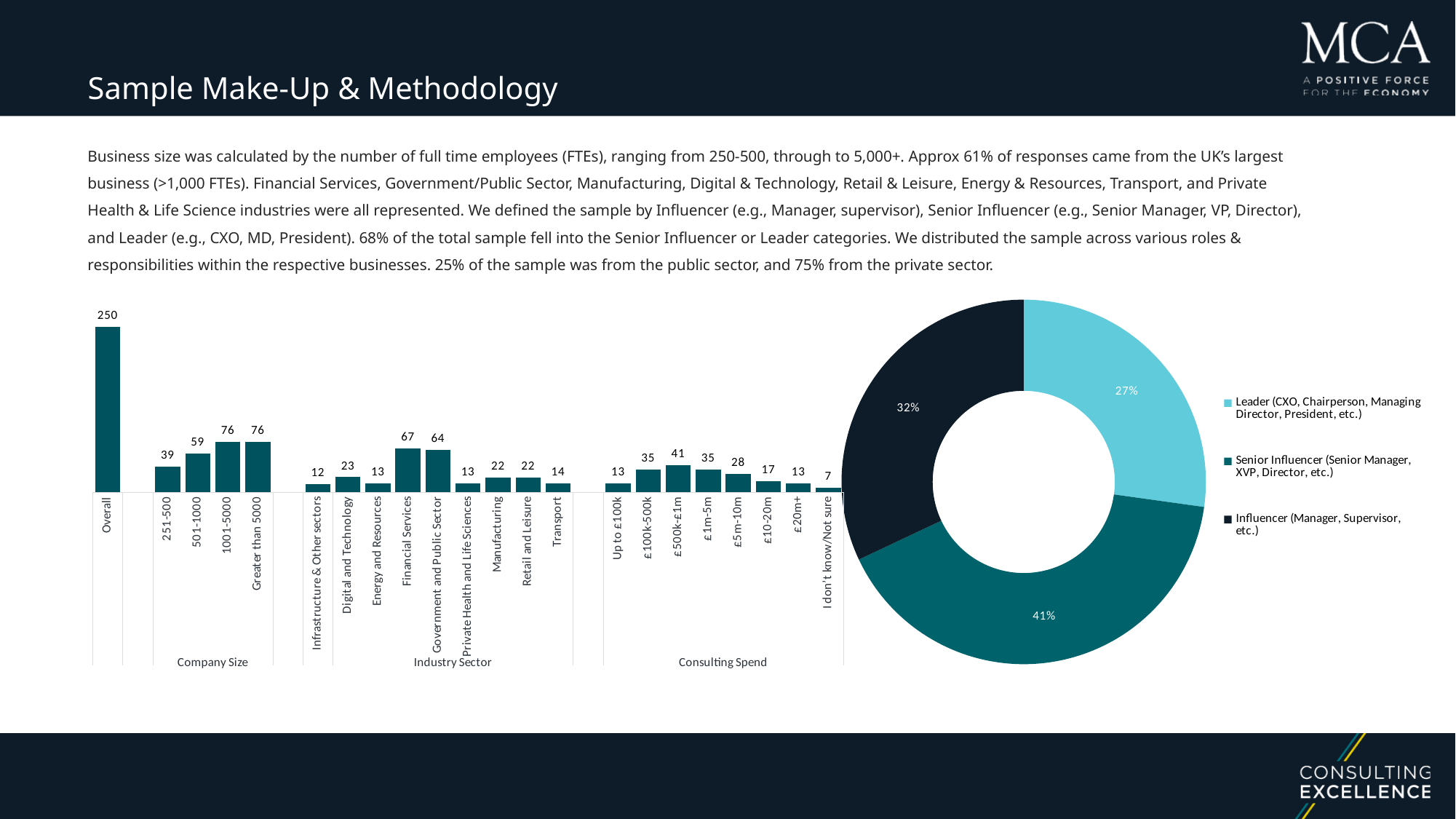
On the bar chart on the left, what is the value for the 251-500 company size category? 39 On the donut chart on the right, what share is Senior Influencer (Senior Manager, XVP, Director, etc.)? 41% On the bar chart on the left, which is larger: Digital and Technology or Manufacturing? Digital and Technology On the bar chart on the left, what is the value for £500k-£1m consulting spend? 41 On the bar chart on the left, how many Consulting Spend categories are shown? 8 On the bar chart on the left, which Industry Sector category has the lowest value? Infrastructure & Other sectors On the donut chart on the right, which category has the smallest share? Leader (CXO, Chairperson, Managing Director, President, etc.) On the bar chart on the left, which Consulting Spend category has the highest value? £500k-£1m On the bar chart on the left, what is the value for Financial Services? 67 What kind of chart is on the right of the slide? Donut chart How many entries does the legend of the donut chart on the right list? 3 On the bar chart on the left, what is the difference between Financial Services and Government and Public Sector? 3